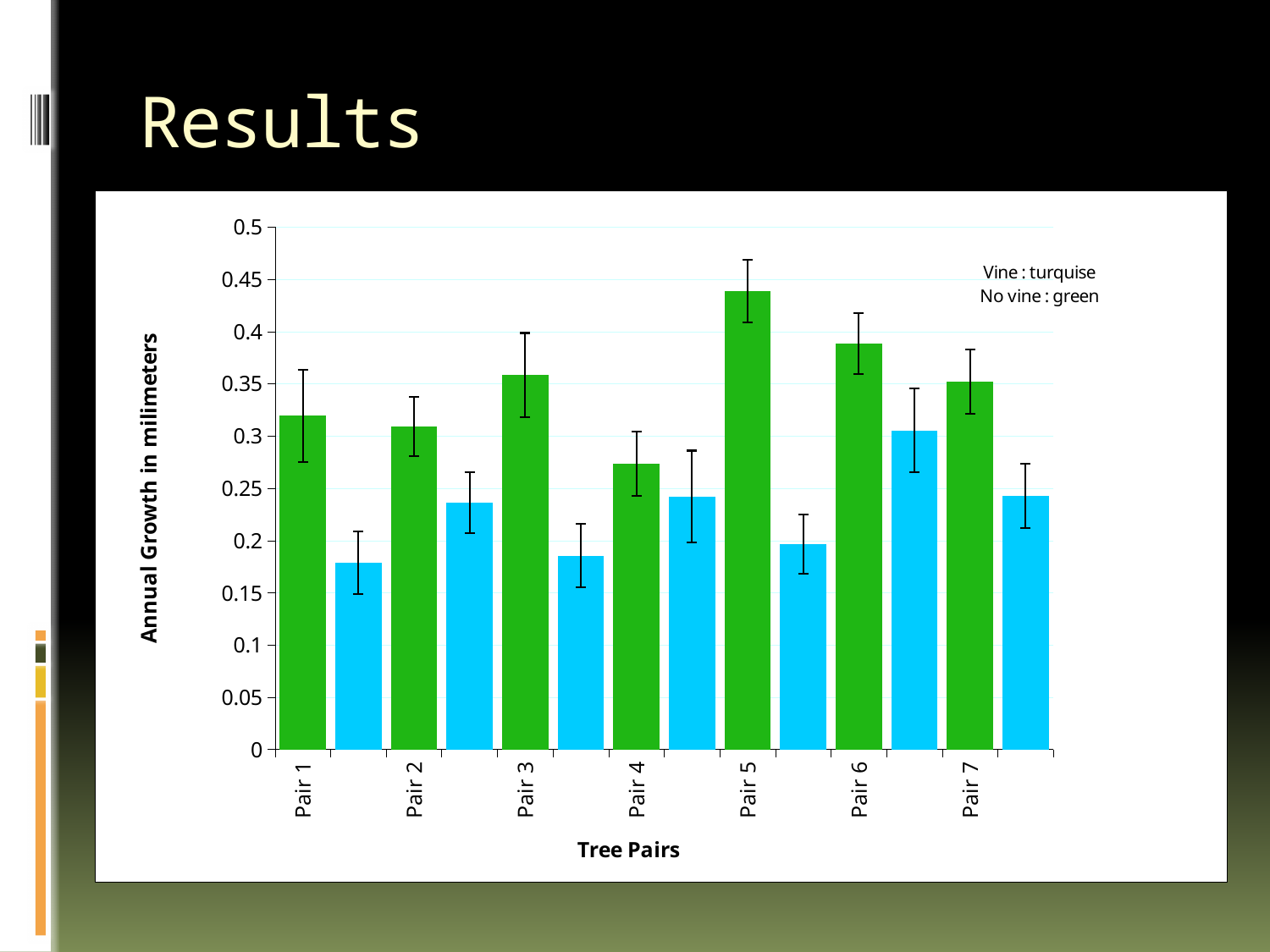
For Pair 3, which bar is taller: the green (no vine) bar or the turquoise (vine) bar? green (no vine) What kind of chart is shown on the slide? bar chart Is the green (no vine) bar for Pair 5 greater or less than 0.4? greater Which tree pair has the tallest turquoise (vine) bar? Pair 6 Which tree pair has the tallest green (no vine) bar? Pair 5 Is the green (no vine) bar for Pair 4 greater or less than 0.3? less Is the turquoise (vine) bar for Pair 1 greater or less than 0.2? less What is the title of the y axis? Annual Growth in milimeters Which tree pair has the shortest green (no vine) bar? Pair 4 How many tree pairs are shown on the x axis? 7 According to the legend text, which colour represents trees with a vine? turquise